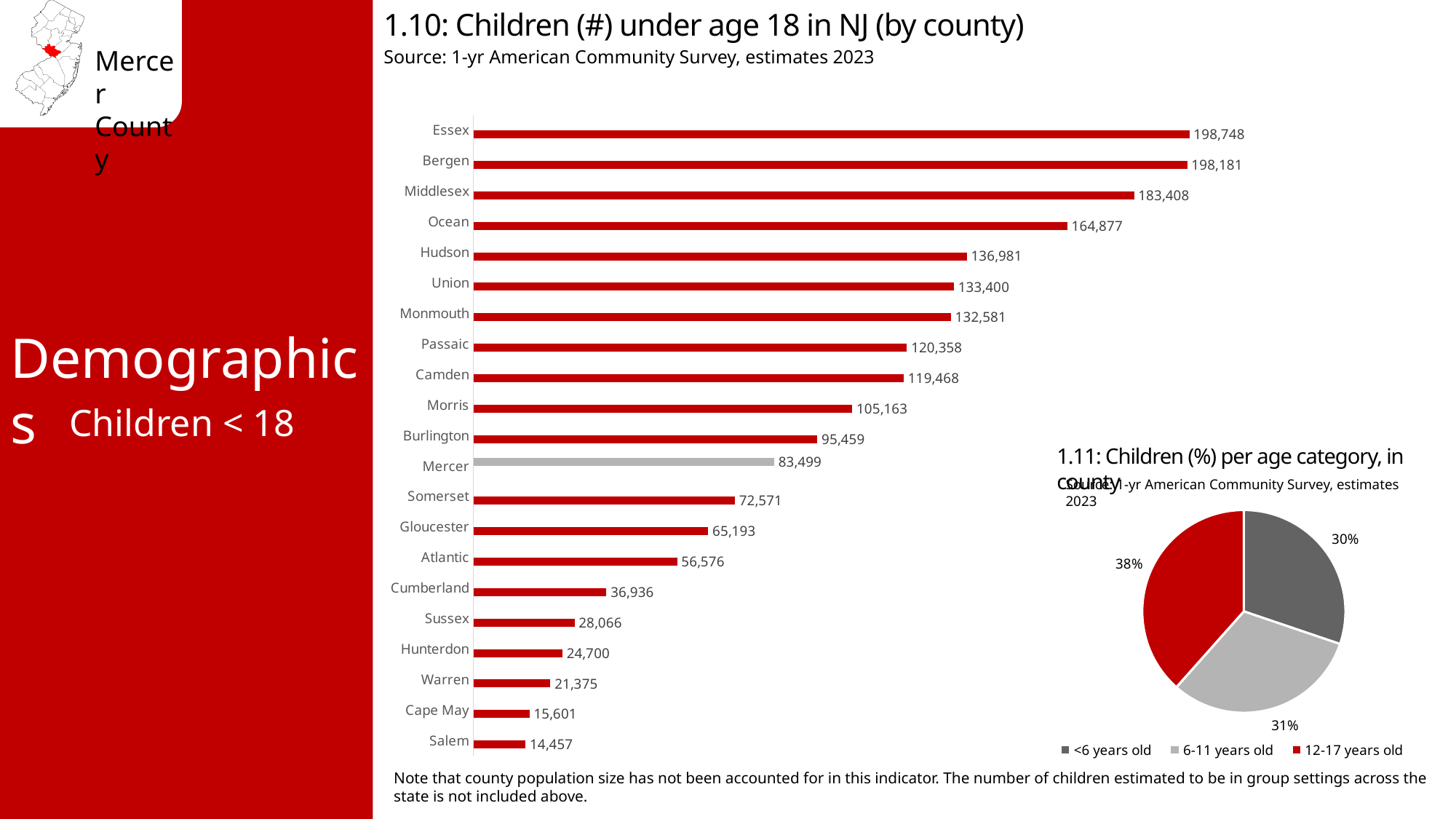
In chart 1.11 (Children (%) per age category, in county), what share of children are 12-17 years old? 38% In chart 1.10, which is larger, the value for Hudson or the value for Passaic? Hudson In chart 1.10, how many counties are shown? 21 What kind of chart is chart 1.10? Bar chart How many categories does the legend of chart 1.11 list? 3 In chart 1.10, which county has the highest number of children under 18? Essex In chart 1.10, what is the difference between the values for Essex and Mercer? 115,249 In chart 1.11, which age category has the smallest share? <6 years old In chart 1.10 (Children under age 18 in NJ by county), what is the value for Mercer? 83,499 In chart 1.10, what is the value for Ocean? 164,877 In chart 1.10, which county's bar is coloured grey instead of red? Mercer In chart 1.10, which county has the lowest number of children under 18? Salem